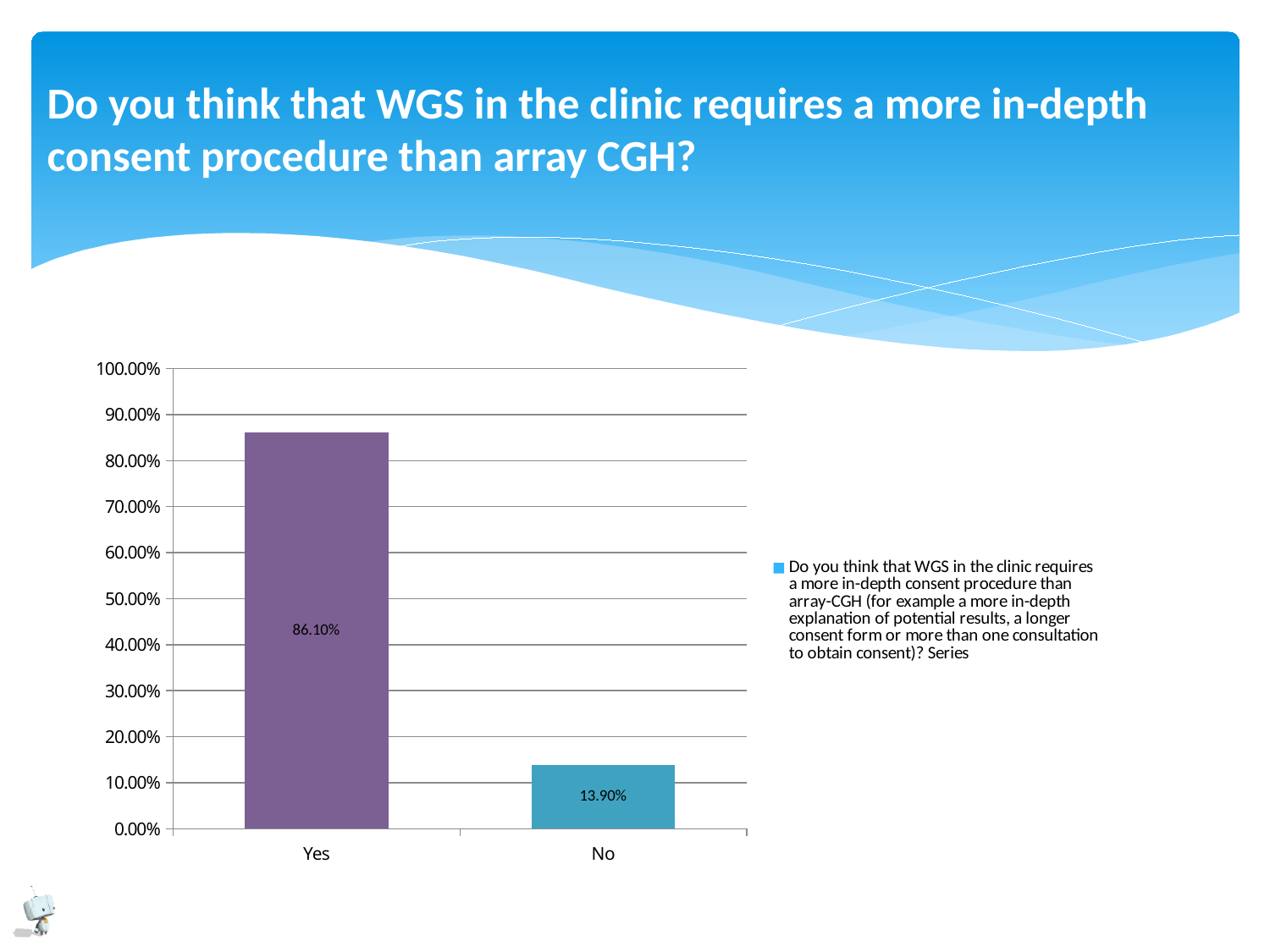
Which category has the highest value? Yes What kind of chart is shown on the slide? bar chart Which category has the lowest value? No What is the highest value shown on the y axis? 100.00% What is the value for No? 13.90% How many categories are shown on the x axis? 2 What is the value for Yes? 86.10% Which is larger, the value for Yes or the value for No? Yes What is the difference between the values for Yes and No? 72.20% Is the value for No greater or less than 20.00%? less Is the value for Yes greater or less than 80.00%? greater How many series does the legend list? 1